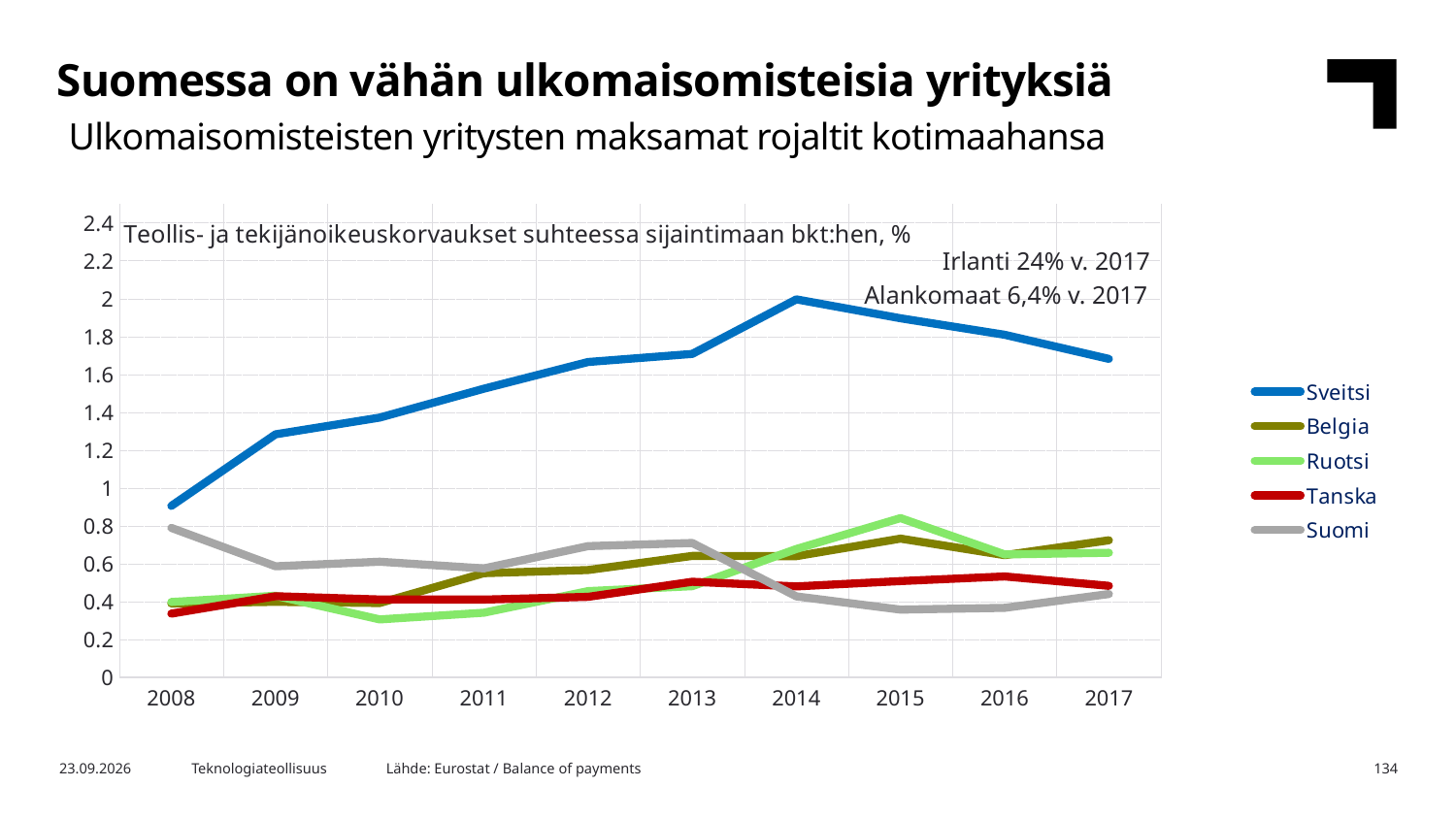
Is the value for Sveitsi in 2008 greater or less than 1? less How many years are shown on the x axis? 10 Does the Sveitsi line rise or fall from 2008 to 2014? rise According to the annotation on the chart, what was the value for Irlanti in 2017? 24% What kind of chart is shown on the slide? line chart Is the value for Sveitsi in 2014 greater or less than 1.8? greater Which series has the highest value in 2017? Sveitsi In 2015, which is larger: the value for Ruotsi or the value for Belgia? Ruotsi How many series does the legend list? 5 Is the value for Suomi in 2008 greater or less than 0.6? greater Which series has the lowest value in 2015? Suomi In 2008, which is larger: the value for Sveitsi or the value for Suomi? Sveitsi